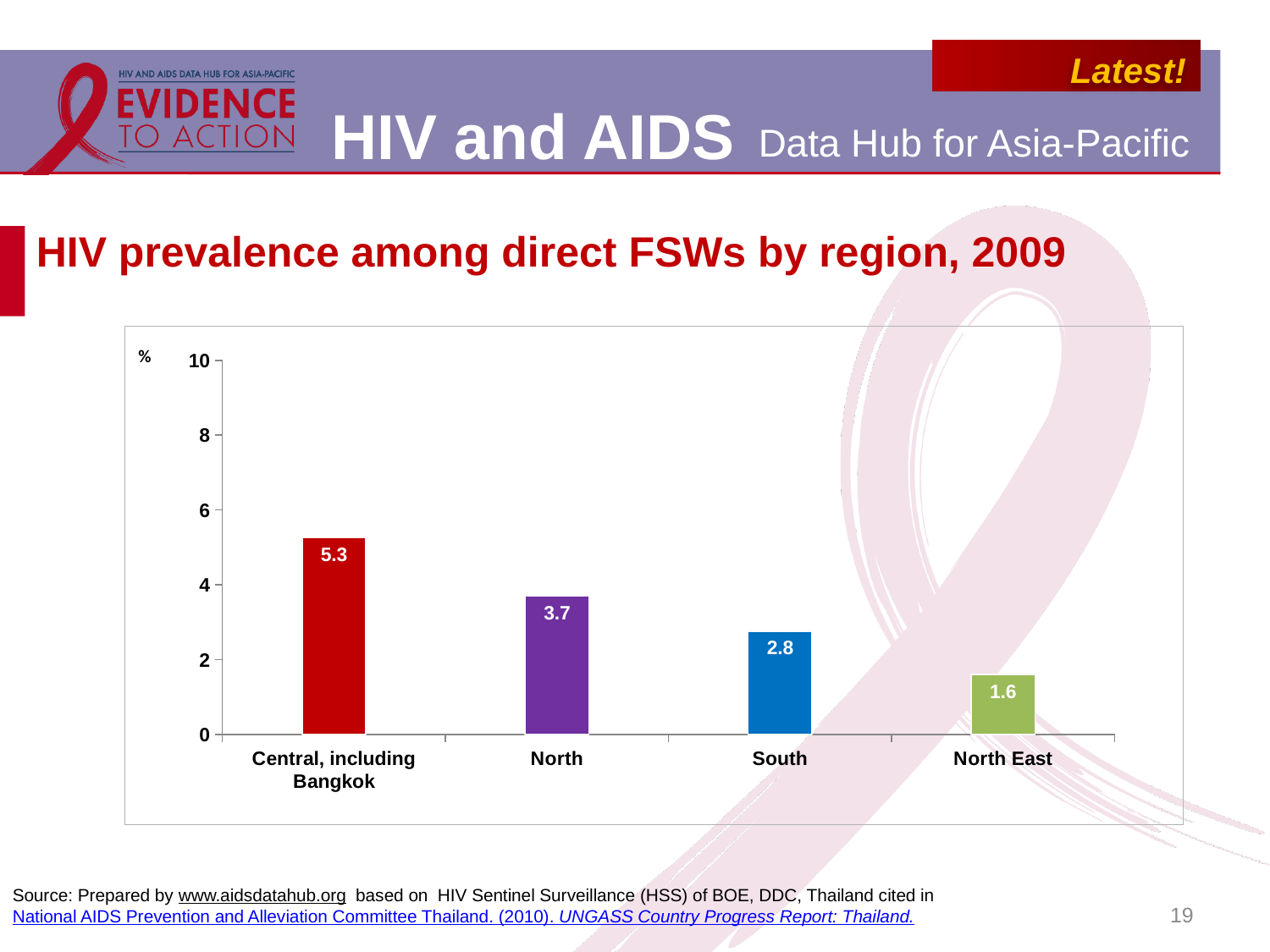
What is the difference in HIV prevalence between Central, including Bangkok and North East? 3.7 Which region has the lowest HIV prevalence among direct FSWs? North East How many regions are shown in the chart? 4 Which region has the highest HIV prevalence among direct FSWs? Central, including Bangkok What kind of chart is shown on the slide? Bar chart What is the HIV prevalence among direct FSWs in the South region? 2.8 What is the HIV prevalence among direct FSWs in the North region? 3.7 What is the difference in HIV prevalence between North and South? 0.9 Which region has a higher HIV prevalence, North or South? North What is the HIV prevalence among direct FSWs in the North East region? 1.6 Do the values rise or fall moving from left to right across the regions? Fall What is the HIV prevalence among direct FSWs in Central, including Bangkok? 5.3